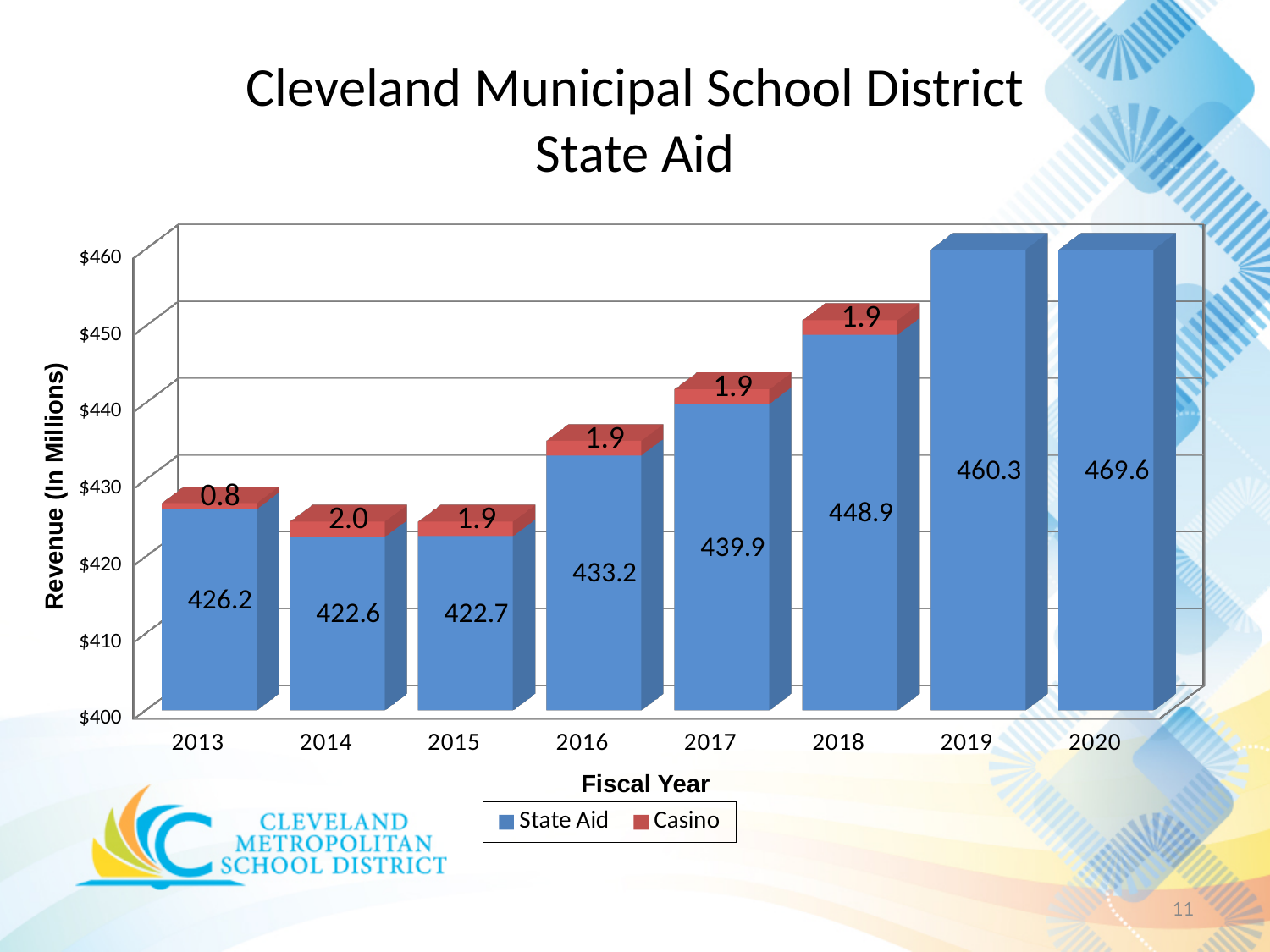
What is the State Aid value for fiscal year 2020? 469.6 What is the Casino value for fiscal year 2014? 2.0 How many series does the legend list? 2 How many fiscal years are shown on the x axis? 8 What is the State Aid value for fiscal year 2016? 433.2 What is the difference between the State Aid values for 2020 and 2013? 43.4 Which fiscal year has the highest State Aid value? 2020 Which is larger, the State Aid value for 2017 or for 2018? 2018 What kind of chart is shown on the slide? Stacked bar chart What is the Casino value for fiscal year 2013? 0.8 Is the State Aid value for 2014 greater or less than $430? less What is the total of the stacked bar for fiscal year 2018 (State Aid plus Casino)? 450.8